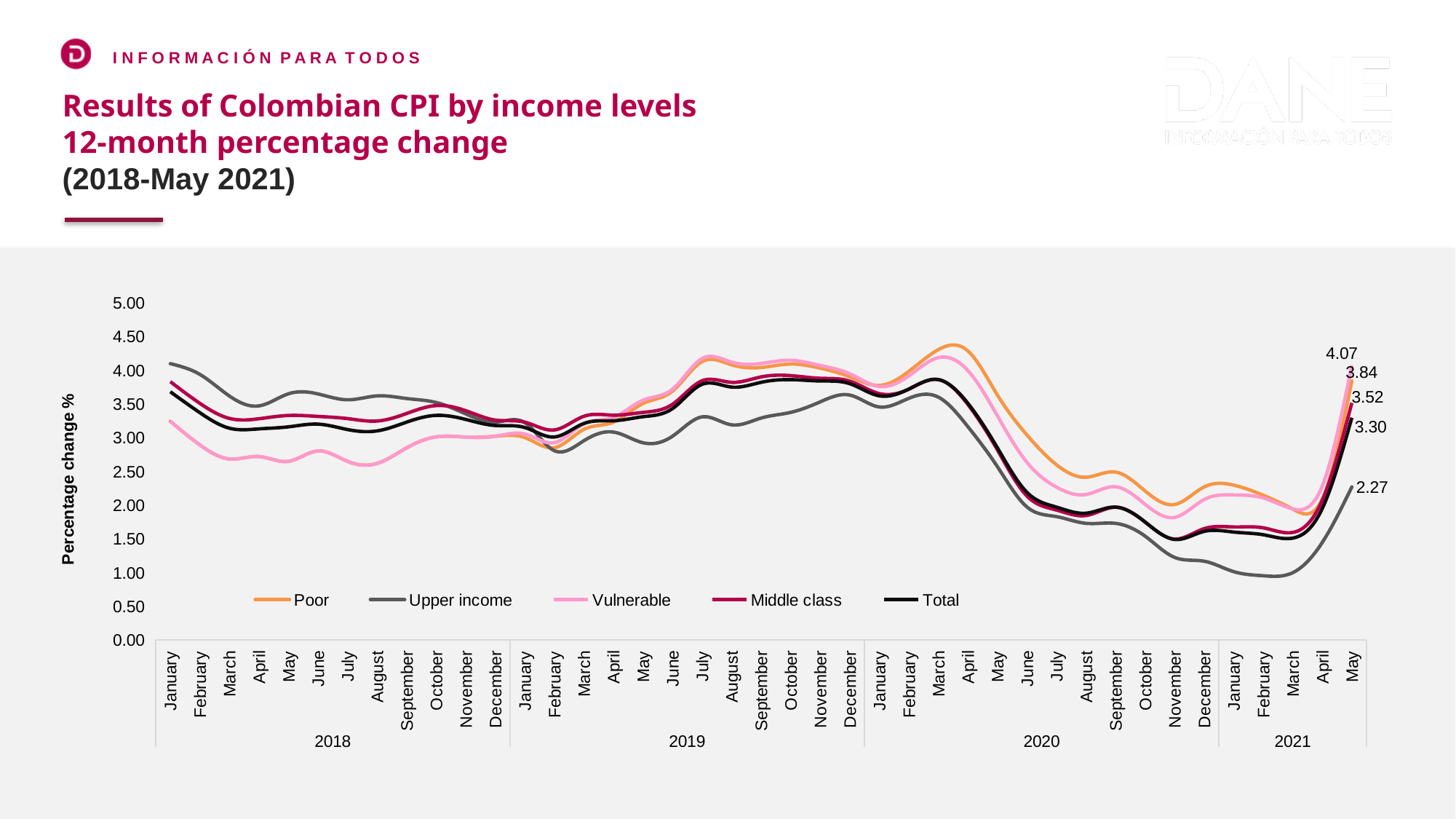
What is the value for Upper income in May 2021? 2.27 Which series has the highest value in May 2021? Vulnerable How many series does the legend list? 5 What is the difference between the Poor and Upper income values in May 2021? 1.57 What is the value for Total in May 2021? 3.30 In May 2021, which is larger: the value for Vulnerable or for Middle class? Vulnerable What is the value for Poor in May 2021? 3.84 What kind of chart is shown on the slide? line chart Is the value for Upper income in March 2021 greater or less than 1.50? less Which series has the lowest value in May 2021? Upper income What is the label on the vertical axis? Percentage change % Is the value for Poor in April 2020 greater or less than 4.00? greater